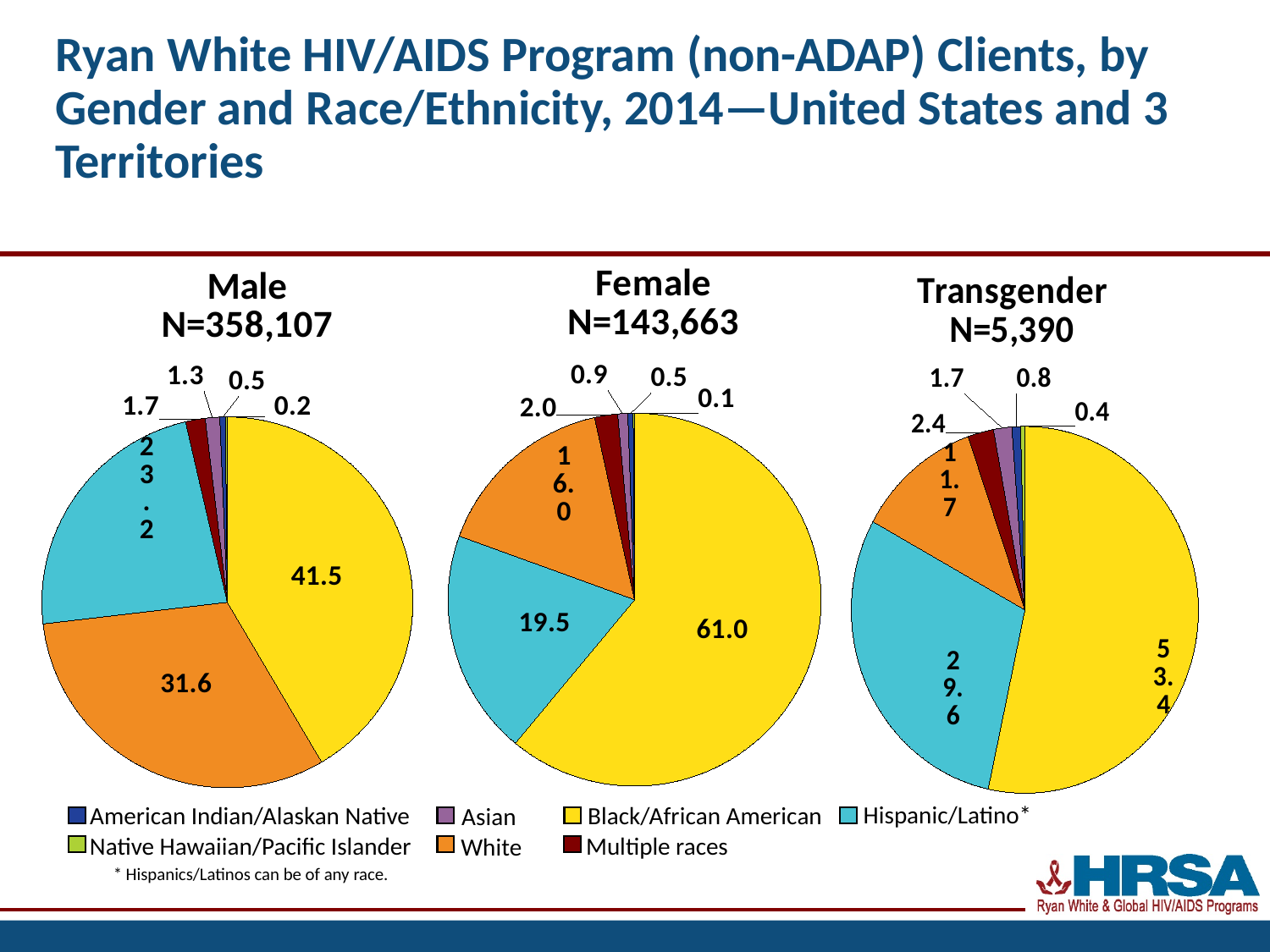
In the Transgender pie chart, what is the value for Hispanic/Latino? 29.6 In the Male pie chart, which is larger, the White share or the Hispanic/Latino share? White In the Male pie chart, which race/ethnicity has the smallest share? Native Hawaiian/Pacific Islander In the Female pie chart, what is the value for Hispanic/Latino? 19.5 How many race/ethnicity categories does the legend list? 7 What is the N value shown for the Transgender pie chart? N=5,390 In the Male pie chart, what is the value for White? 31.6 In the Male pie chart, what is the value for Black/African American? 41.5 In the Female pie chart, what is the value for Black/African American? 61.0 What type of charts are shown on the slide? Pie charts In the Female pie chart, what is the difference between the Black/African American and Hispanic/Latino values? 41.5 In the Transgender pie chart, which race/ethnicity has the largest share? Black/African American